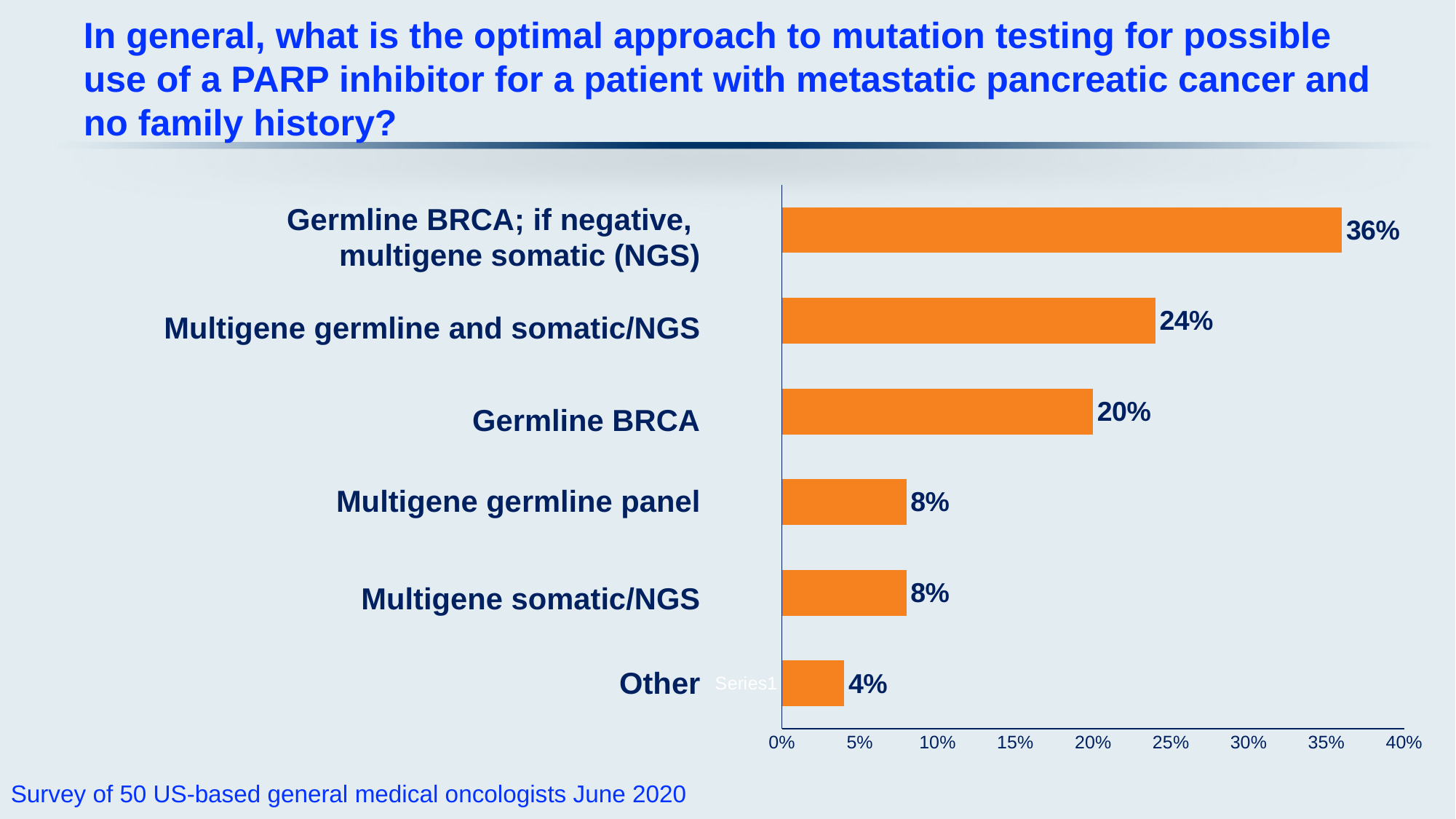
How many categories are shown in the chart? 6 Is the value for "Multigene germline and somatic/NGS" greater or less than 20%? greater What is the value for "Multigene germline and somatic/NGS"? 24% What is the value for "Other"? 4% What kind of chart is shown on the slide? Bar chart What is the difference between the values for "Germline BRCA; if negative, multigene somatic (NGS)" and "Multigene germline and somatic/NGS"? 12% What percentage of respondents chose "Germline BRCA; if negative, multigene somatic (NGS)"? 36% Which category has the lowest value? Other What is the value for "Germline BRCA"? 20% What is the maximum value shown on the horizontal axis? 40% Which category has the highest value? Germline BRCA; if negative, multigene somatic (NGS) Which is larger: the value for "Germline BRCA" or the value for "Multigene germline panel"? Germline BRCA